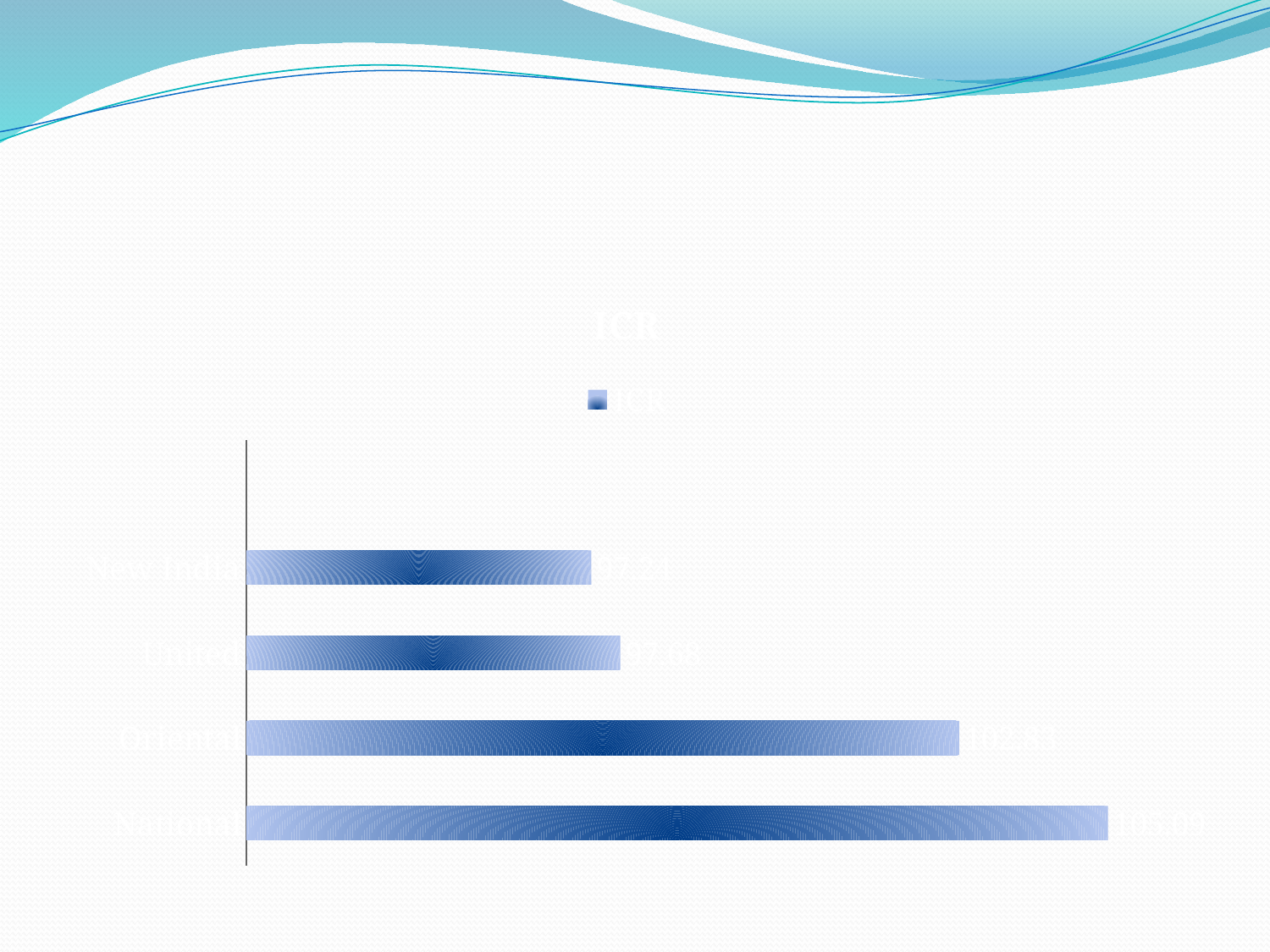
What is the ICR value for United? 97.68 What is the difference between the ICR of National and the ICR of New India? 7.85 What is the difference between the ICR of Oriental and the ICR of United? 5.15 What is the ICR value for National? 105.09 What type of chart is shown on the slide? Bar chart Which company has the lowest ICR? New India What is the ICR value for New India? 97.24 Which company has the highest ICR? National Which has a larger ICR, Oriental or New India? Oriental How many companies are shown in the chart? 4 What is the ICR value for Oriental? 102.83 What is the title of the chart? ICR